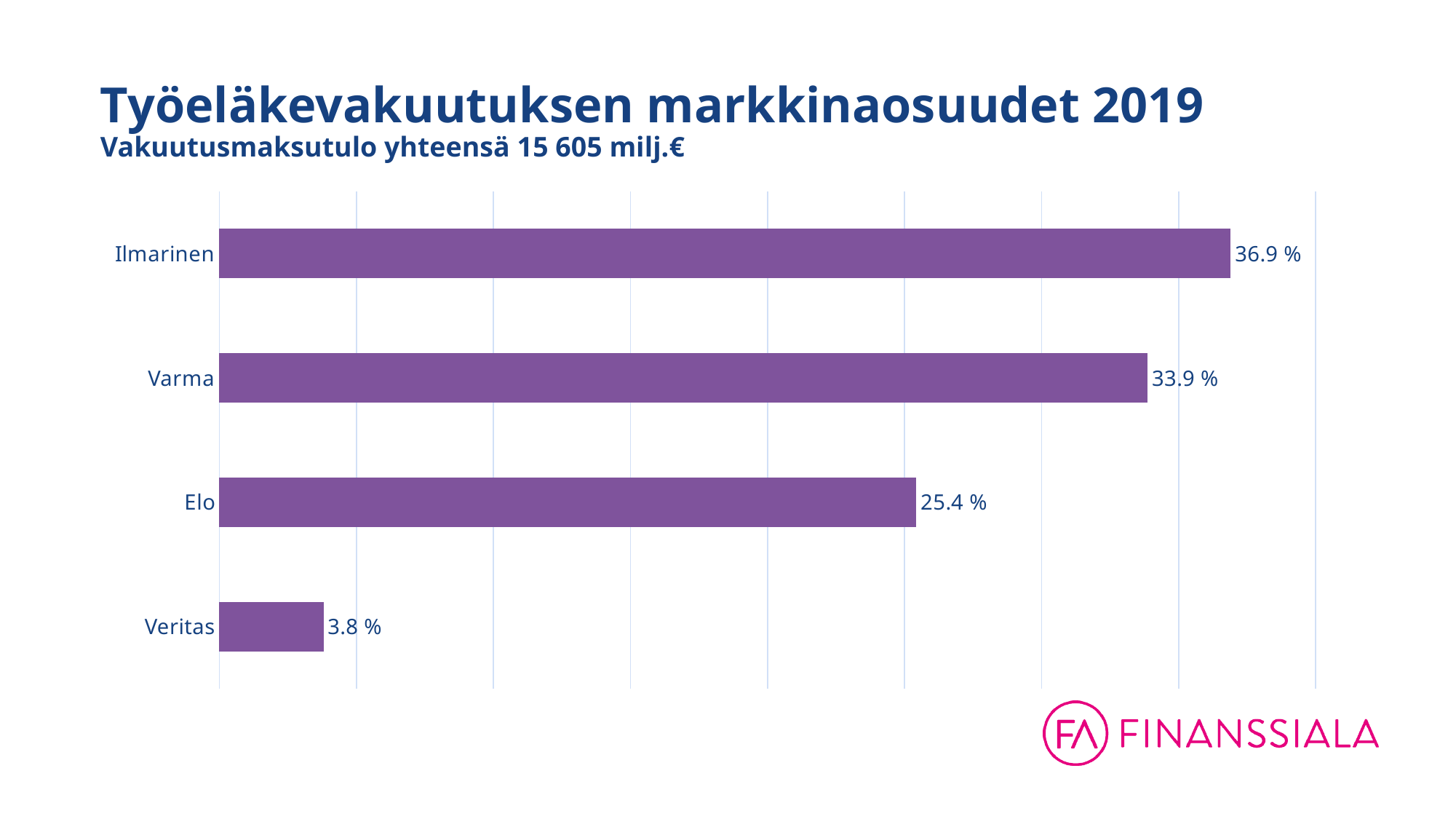
Which company has the largest market share? Ilmarinen What is the market share shown for Varma? 33.9 % What is the market share shown for Ilmarinen? 36.9 % Which has a larger market share, Varma or Elo? Varma What is the difference in percentage points between Elo's and Veritas's market shares? 21.6 percentage points What is the market share shown for Elo? 25.4 % Which company has the smallest market share? Veritas What kind of chart is shown on the slide? Bar chart What is the market share shown for Veritas? 3.8 % How many companies are shown in the chart? 4 What is the difference in percentage points between Ilmarinen's and Varma's market shares? 3.0 percentage points What is the title of the chart? Työeläkevakuutuksen markkinaosuudet 2019